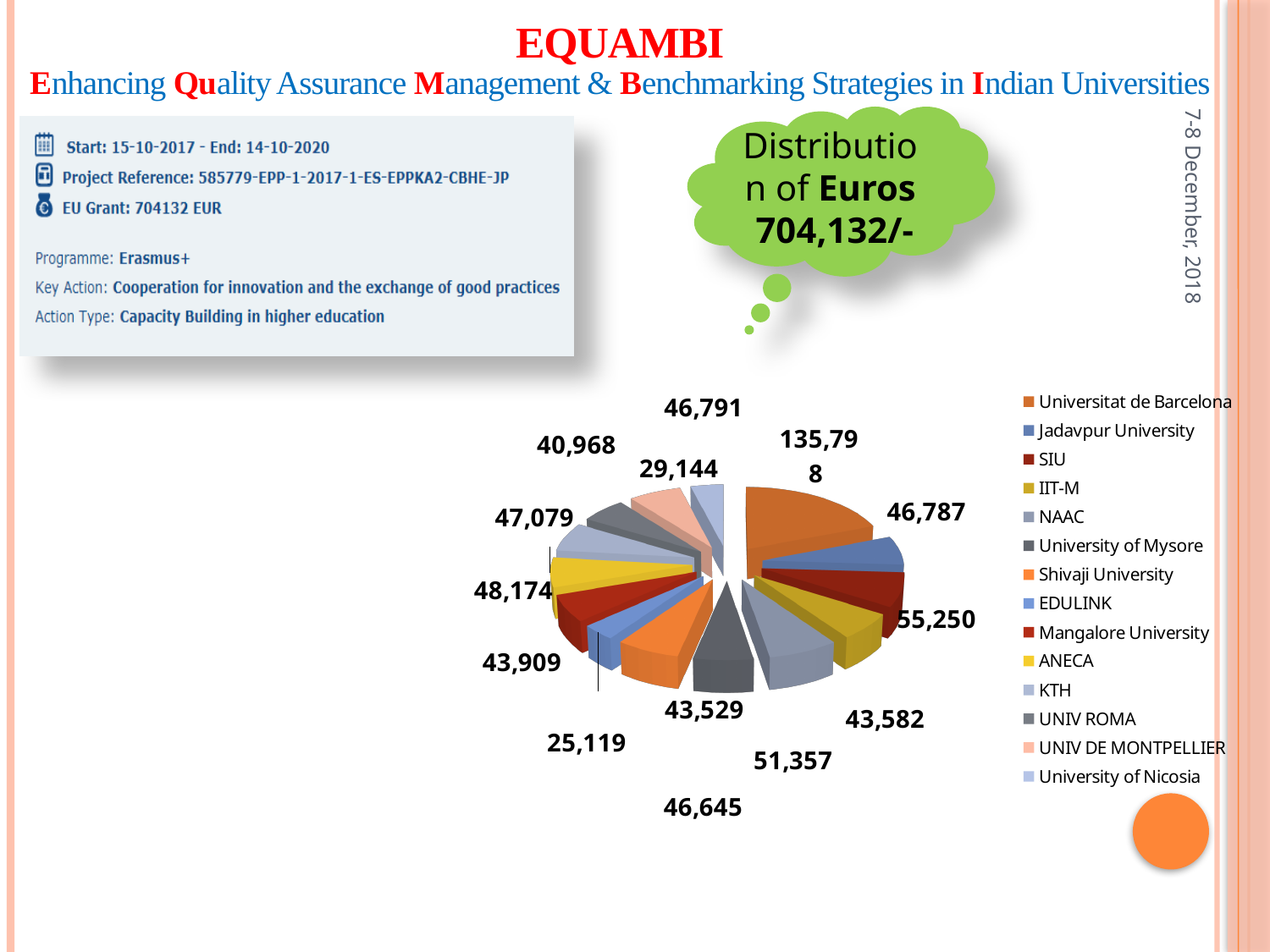
What is the value shown for EDULINK? 25,119 What is the value shown for SIU? 55,250 What is the value shown for Universitat de Barcelona? 135,798 How many entries does the legend of the pie chart list? 14 What is the value shown for UNIV DE MONTPELLIER? 46,791 Which institution receives the largest share of the Euros in the pie chart? Universitat de Barcelona What is the difference between the values for Universitat de Barcelona and EDULINK? 110,679 How many slices does the pie chart have? 14 What total amount of Euros does the pie chart distribute, according to the slide? 704,132 Which is larger, the value for SIU or the value for EDULINK? SIU What kind of chart is shown on the slide? pie chart Which institution has the smallest slice in the pie chart? EDULINK